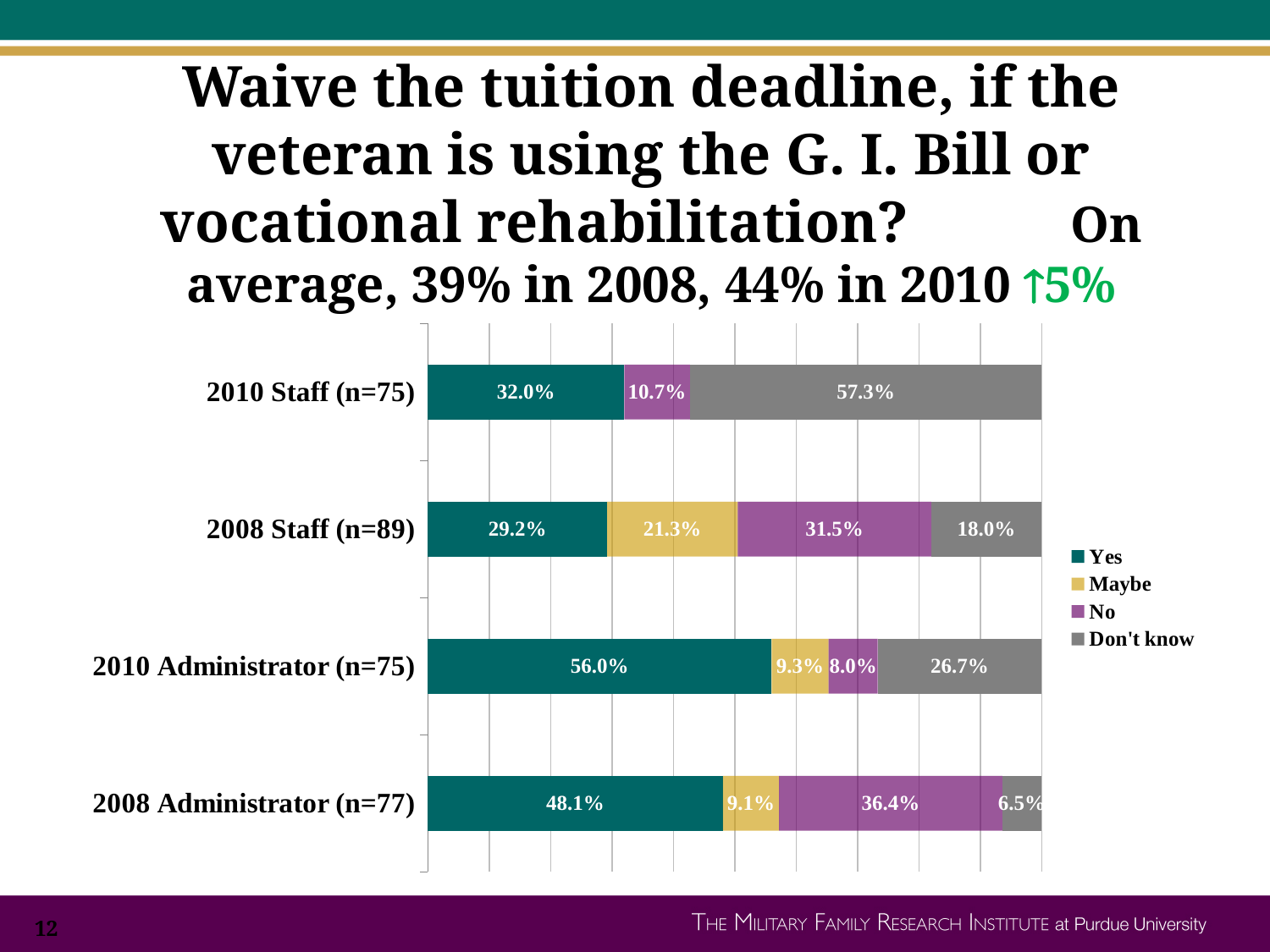
How many response categories does the legend list? 4 By how many percentage points did the Yes response for Administrators increase from 2008 to 2010? 7.9 percentage points What is the Don't know value for 2010 Staff (n=75)? 57.3% How many groups (bars) are shown in the chart? 4 What percentage of 2010 Administrators (n=75) answered Yes? 56.0% What type of chart is shown on the slide? Stacked bar chart What is the difference between the No percentage for 2008 Staff and 2010 Staff? 20.8 percentage points Which group has the lowest Don't know percentage? 2008 Administrator (n=77) Which group has a larger Don't know percentage, 2010 Staff or 2008 Staff? 2010 Staff (n=75) What percentage of 2008 Administrators (n=77) answered No? 36.4% Which group has the highest Yes percentage? 2010 Administrator (n=75) What is the Maybe value for 2008 Staff (n=89)? 21.3%